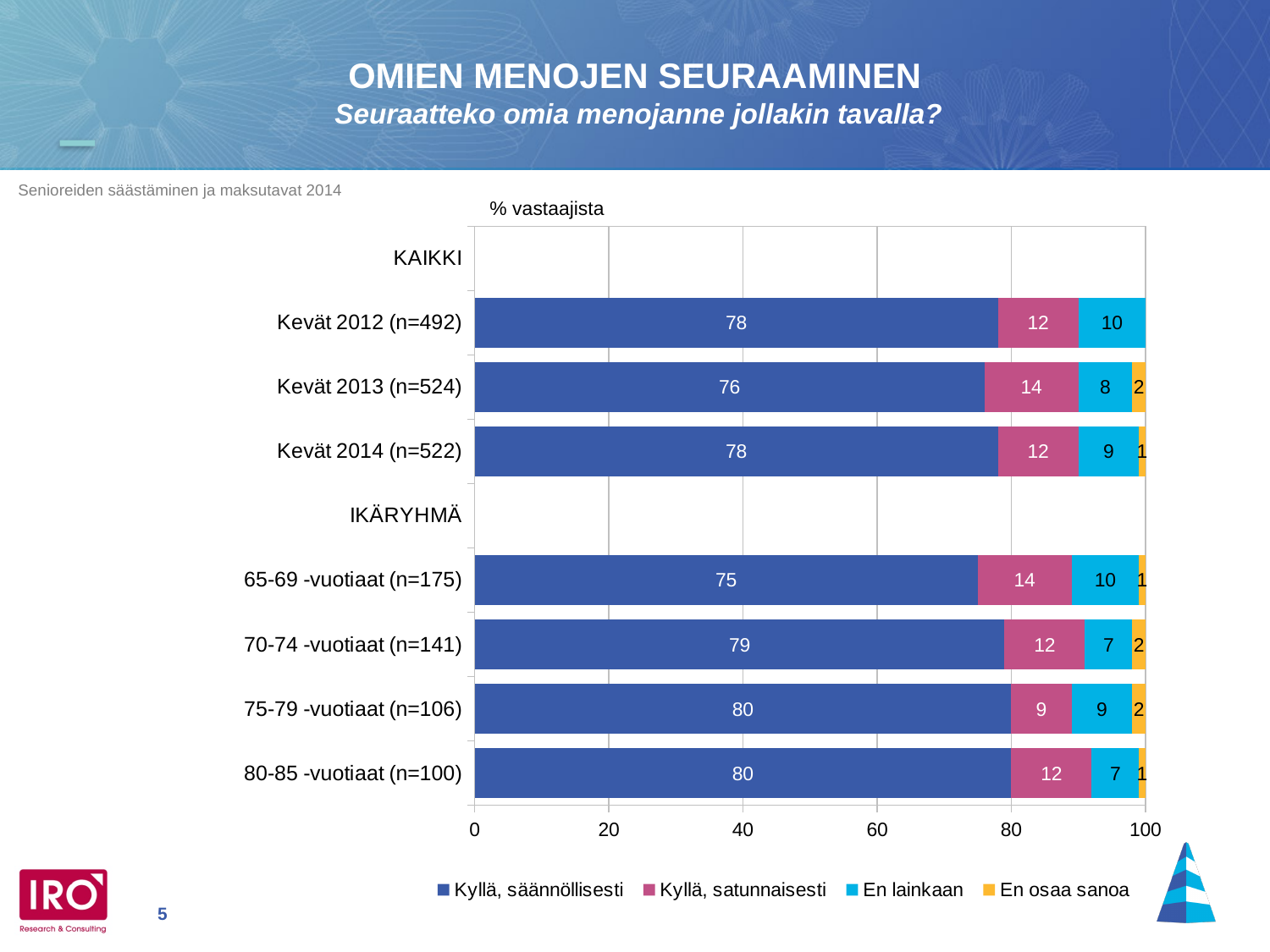
What label is shown above the chart area? % vastaajista What kind of chart is shown on the slide? Stacked bar chart What is the value for "En lainkaan" for Kevät 2012 (n=492)? 10 What is the value for "En osaa sanoa" for 75-79 -vuotiaat (n=106)? 2 Which is larger: the "En lainkaan" value for Kevät 2013 (n=524) or for 70-74 -vuotiaat (n=141)? Kevät 2013 (n=524) What is the value for "Kyllä, säännöllisesti" for Kevät 2013 (n=524)? 76 Is the "Kyllä, säännöllisesti" value for Kevät 2014 (n=522) greater or less than 60? greater What is the value for "Kyllä, satunnaisesti" for 65-69 -vuotiaat (n=175)? 14 How many series does the legend list? 4 What is the difference between the "Kyllä, säännöllisesti" values for 75-79 -vuotiaat (n=106) and 65-69 -vuotiaat (n=175)? 5 Which age group has the lowest value for "Kyllä, säännöllisesti"? 65-69 -vuotiaat (n=175) What is the total of the stacked bar for 80-85 -vuotiaat (n=100)? 100